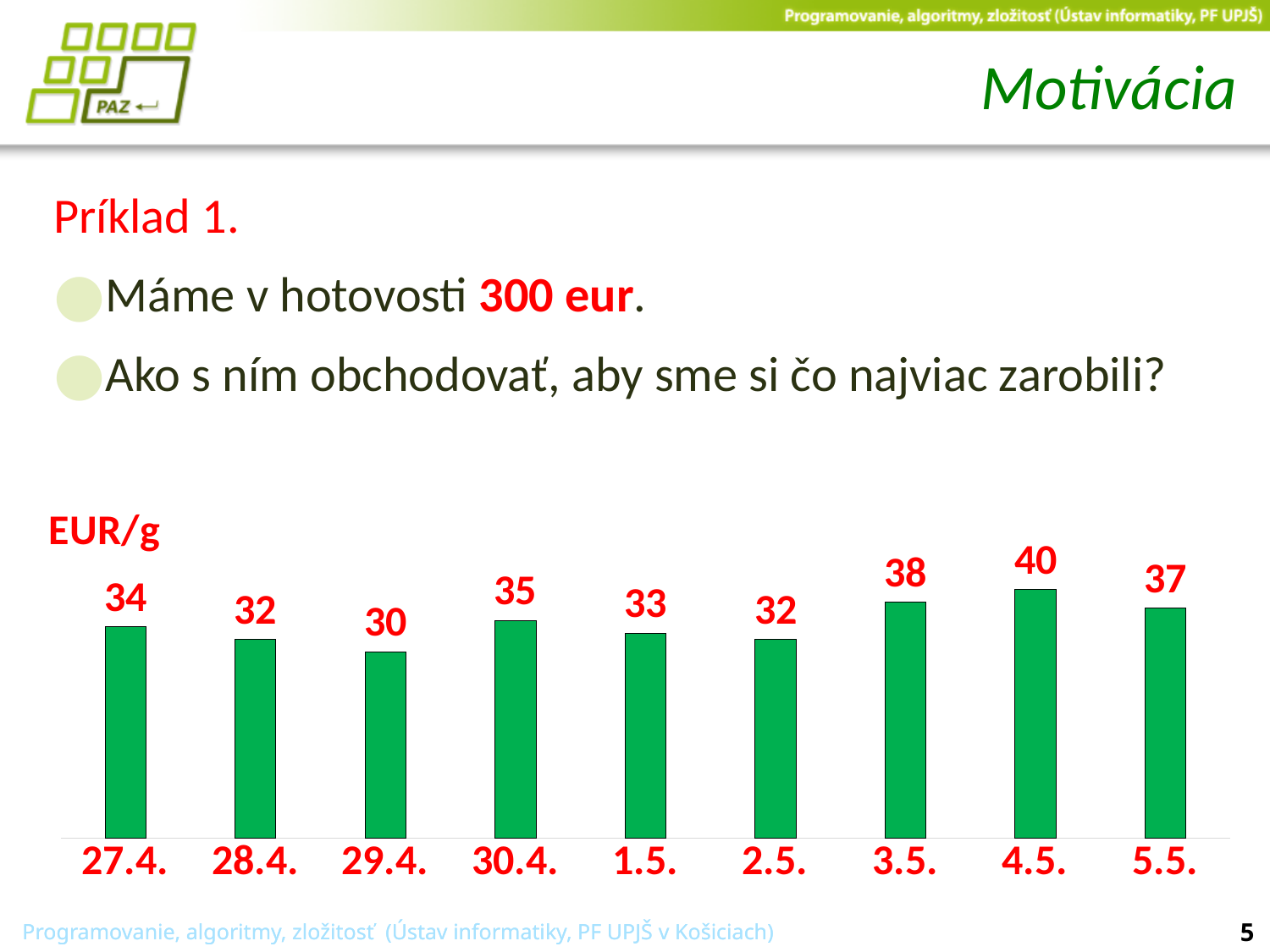
What kind of chart is shown on the slide? bar chart What is the value for 27.4.? 34 What is the value for 29.4.? 30 How many dates are shown on the x axis? 9 Which is larger, the value for 5.5. or the value for 3.5.? 3.5. Do the values rise or fall from 1.5. to 4.5.? rise What is the difference between the values for 4.5. and 29.4.? 10 What is the difference between the values for 30.4. and 1.5.? 2 Which date has the lowest value? 29.4. Which date has the highest value? 4.5. What unit label is shown above the chart? EUR/g What is the value for 3.5.? 38